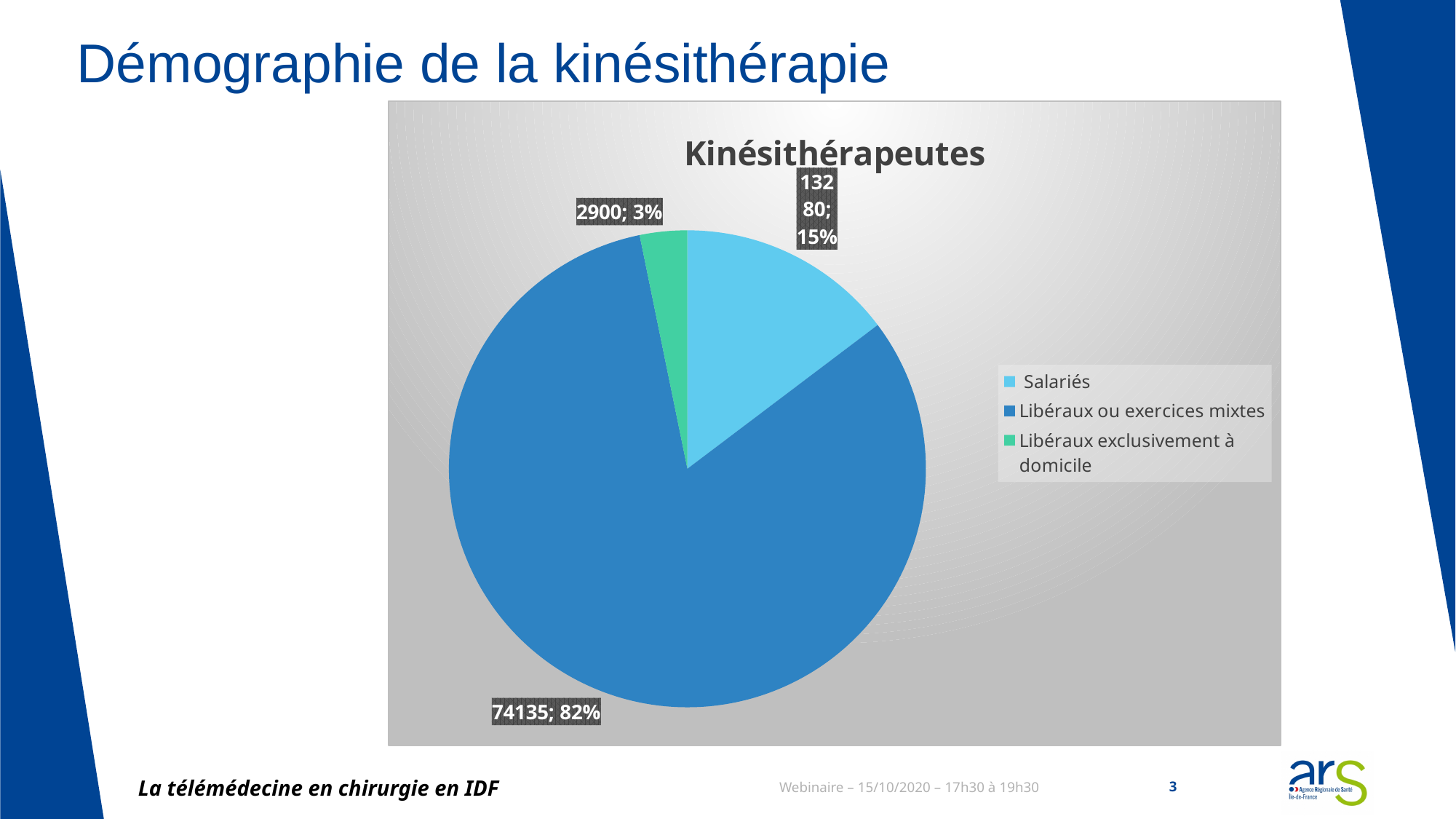
Which category has the smallest slice? Libéraux exclusivement à domicile What value is shown for Libéraux ou exercices mixtes? 74135 What is the difference between the values for Libéraux ou exercices mixtes and Salariés? 60855 What is the title of the chart? Kinésithérapeutes How many entries does the legend list? 3 Which category has the largest slice? Libéraux ou exercices mixtes What value is shown for Salariés? 13280 What value is shown for Libéraux exclusivement à domicile? 2900 What share of the pie does Libéraux ou exercices mixtes represent? 82% What kind of chart is shown on the slide? pie chart How many slices does the pie chart have? 3 What share of the pie does Salariés represent? 15%